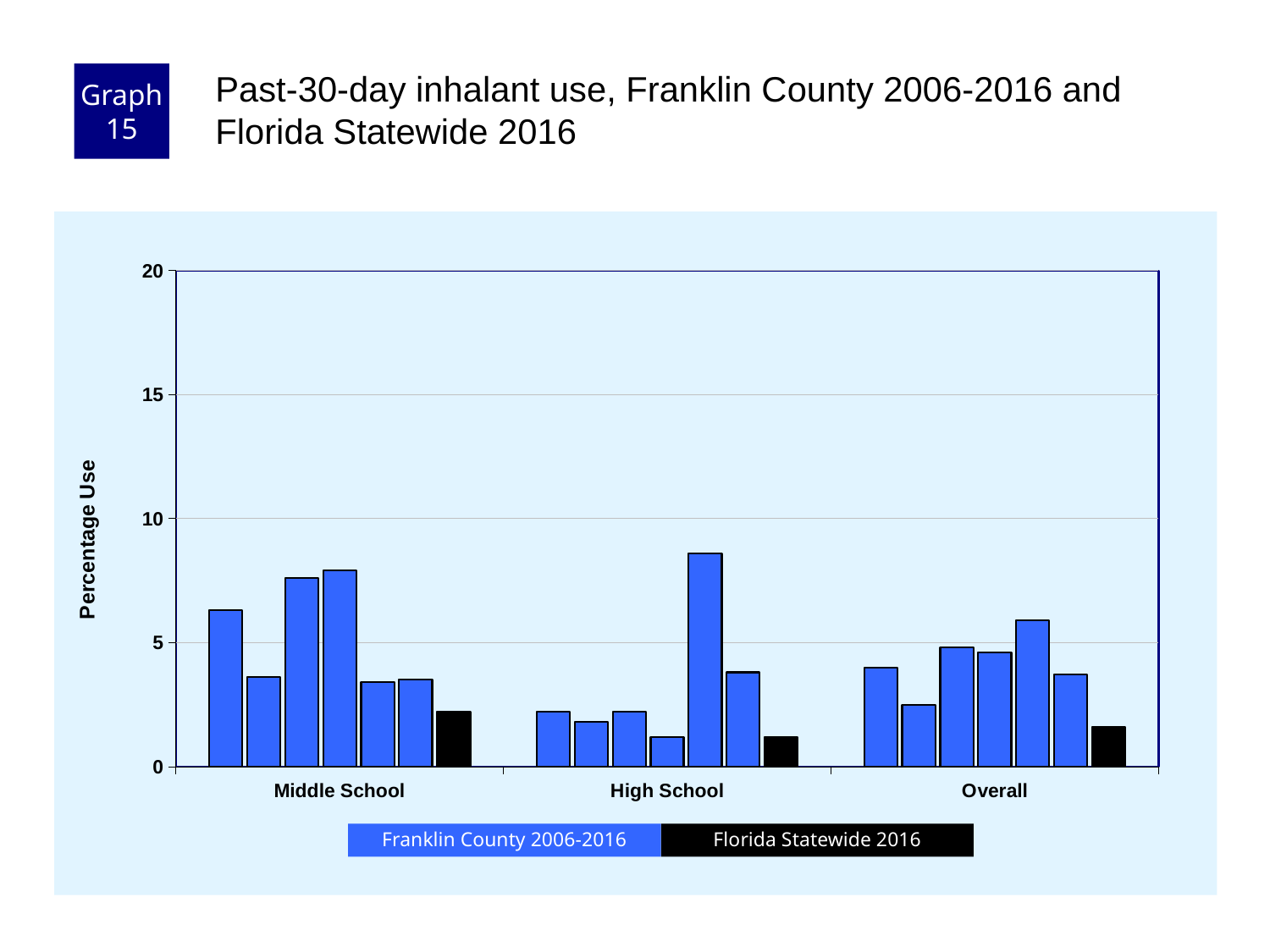
How many series does the legend list? 2 Which colour represents Florida Statewide 2016 in the legend? black Is the Florida Statewide 2016 value for High School greater or less than 5? less Is the Florida Statewide 2016 value for Middle School greater or less than 5? less In which category is the Florida Statewide 2016 value the lowest? High School Is the tallest Franklin County 2006-2016 bar in the Middle School group greater or less than 10? less What is the title of the y axis? Percentage Use How many school-level categories are shown on the x axis? 3 What kind of chart is shown on the slide? bar chart Which is larger, the Florida Statewide 2016 value for Middle School or for High School? Middle School In which category is the Florida Statewide 2016 value the highest? Middle School